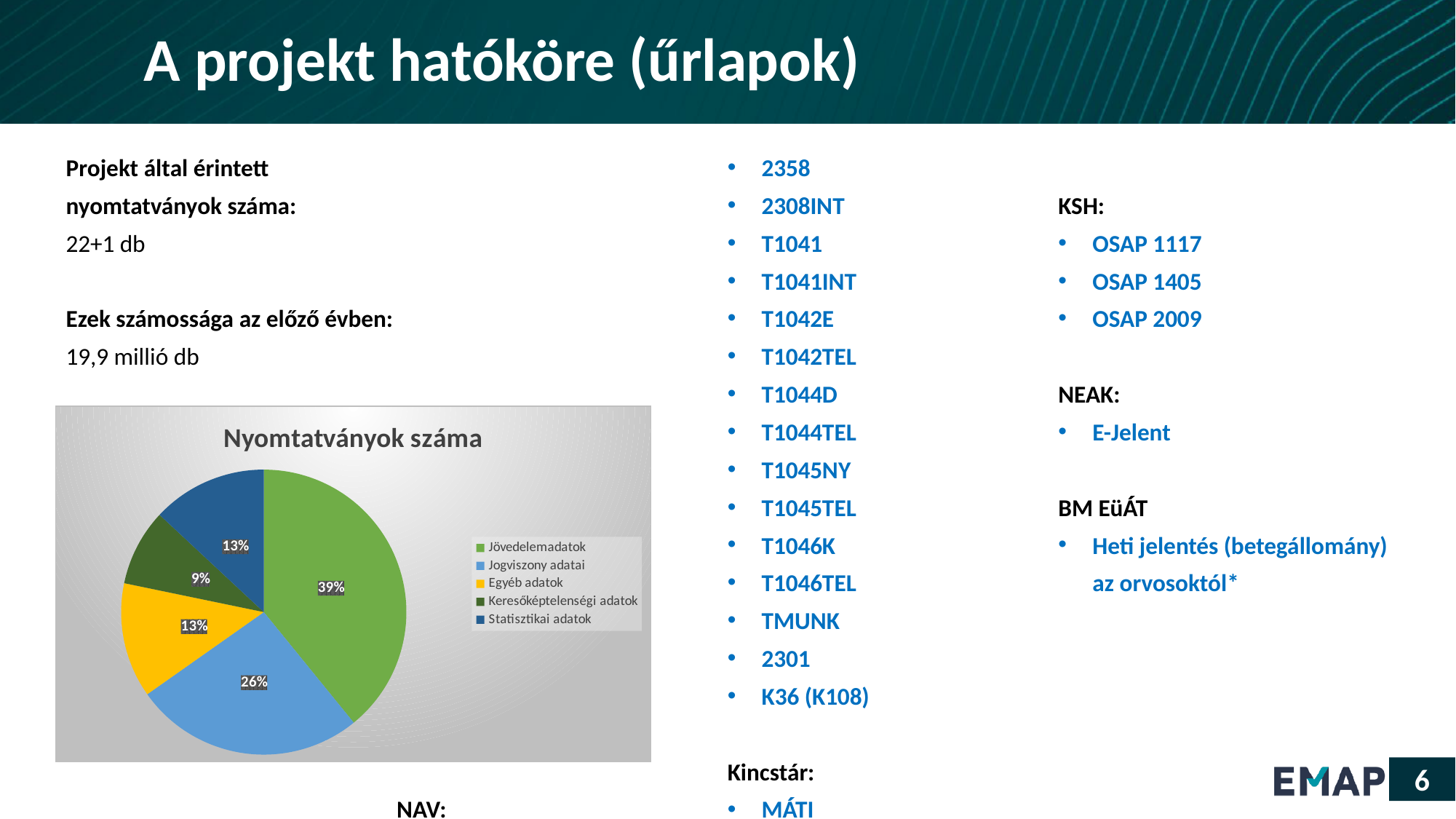
What share of the pie does Jövedelemadatok represent? 39% What share of the pie does Jogviszony adatai represent? 26% What share of the pie does Egyéb adatok represent? 13% What kind of chart is shown on the slide? pie chart Which category has the smallest slice of the pie? Keresőképtelenségi adatok Which colour represents Egyéb adatok in the legend? yellow What is the title of the chart? Nyomtatványok száma Which is larger, the share for Jogviszony adatai or the share for Statisztikai adatok? Jogviszony adatai Which category has the largest slice of the pie? Jövedelemadatok What is the difference in percentage points between Jövedelemadatok and Jogviszony adatai? 13 How many slices does the pie chart have? 5